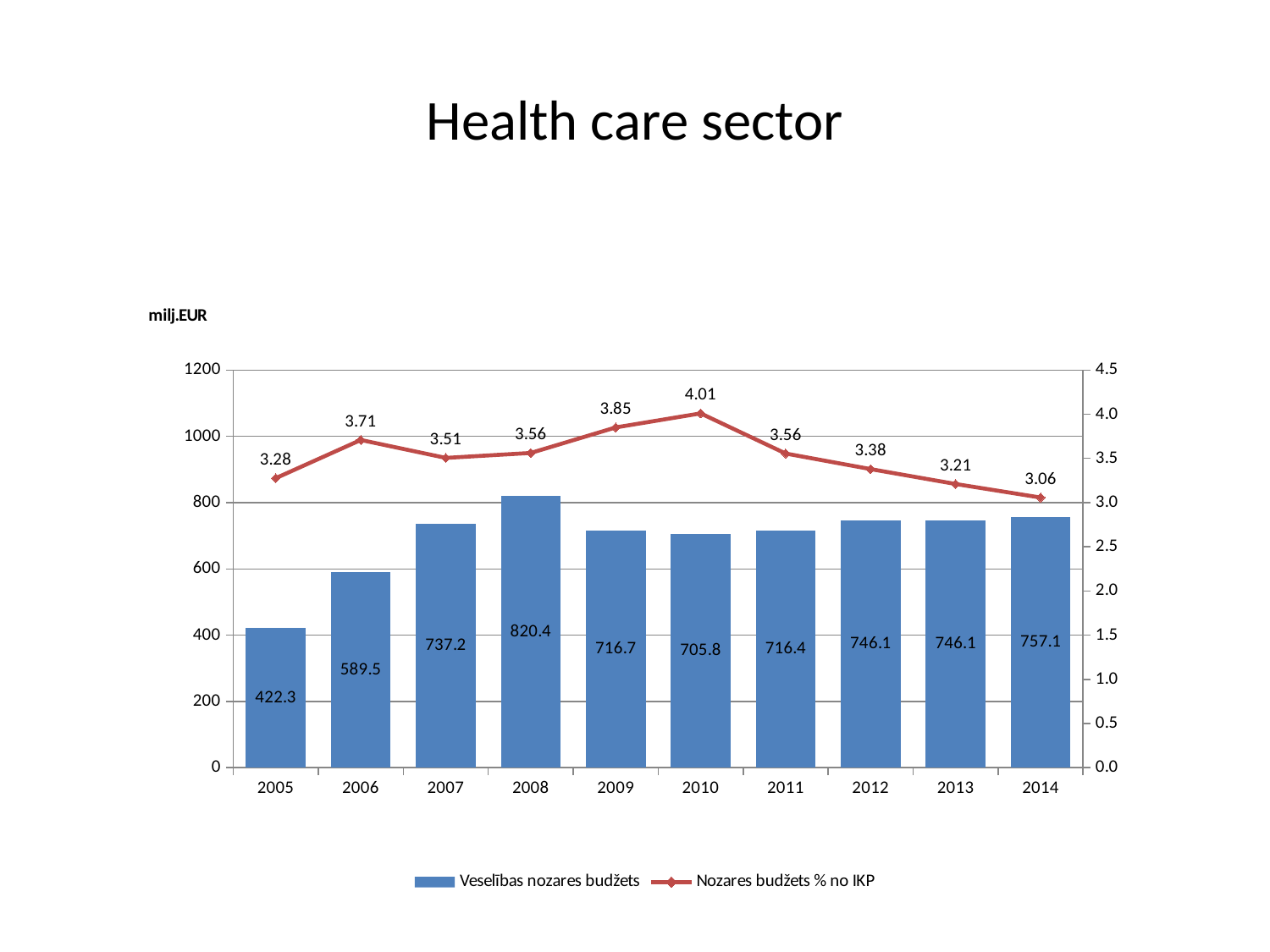
What kind of chart is shown on the slide? Combined bar and line chart What is the value of Nozares budžets % no IKP for 2010? 4.01 Which year has the lowest Nozares budžets % no IKP? 2014 What is the value of Veselības nozares budžets for 2008? 820.4 How many series does the legend list? 2 What is the difference between the Veselības nozares budžets values for 2014 and 2005? 334.8 Which is larger, the Veselības nozares budžets for 2007 or for 2009? 2007 What unit label is shown above the left axis? milj.EUR Which year has the highest Veselības nozares budžets? 2008 What is the value of Veselības nozares budžets for 2005? 422.3 How many years are shown on the x axis? 10 Does the Nozares budžets % no IKP line rise or fall from 2010 to 2014? Fall